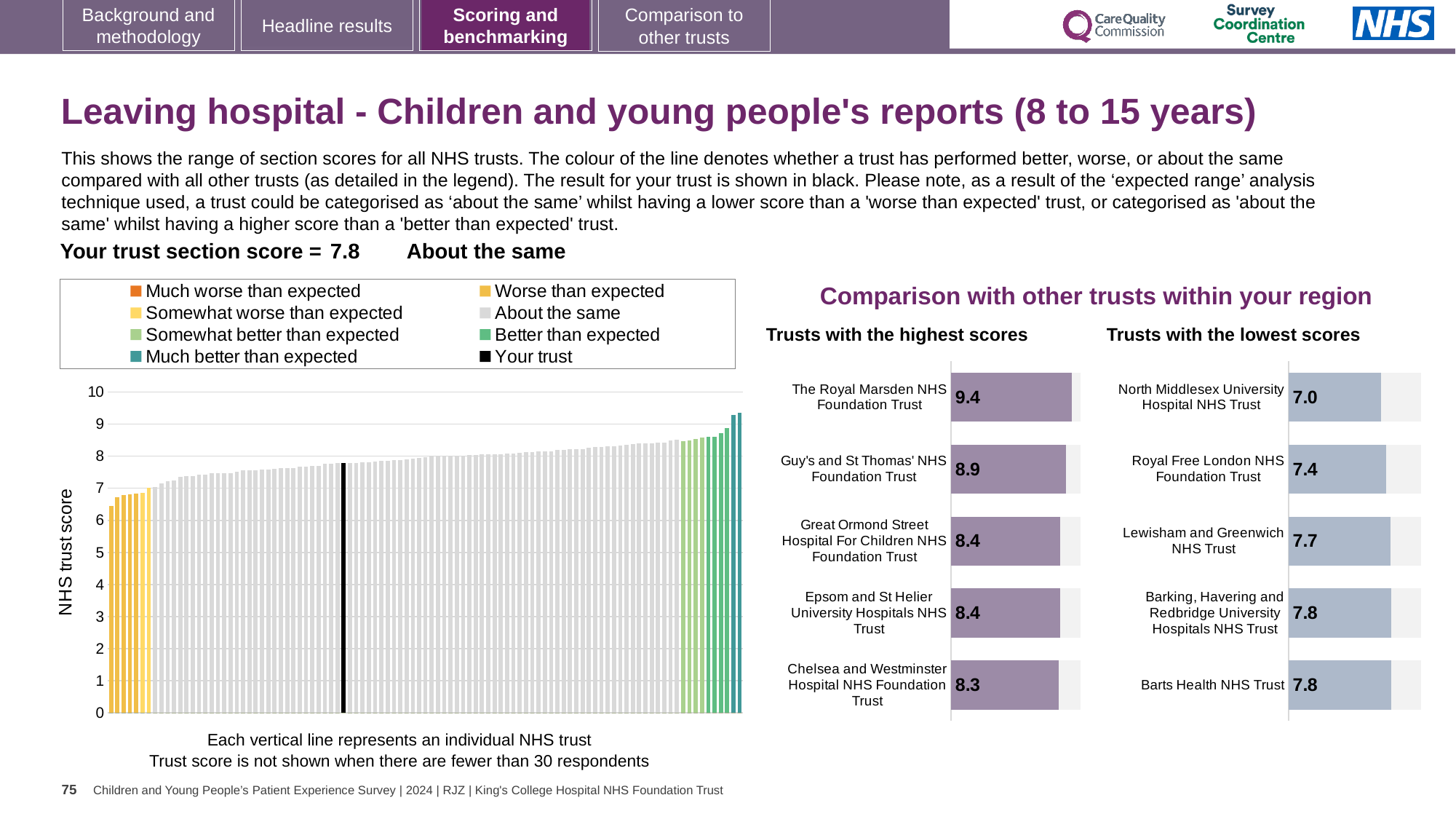
In the main 'NHS trust score' chart, what is the section score for your trust (the black bar)? 7.8 In the 'Trusts with the lowest scores' chart, how much higher is the score for Barts Health NHS Trust than for North Middlesex University Hospital NHS Trust? 0.8 What kind of chart is the main 'NHS trust score' chart on the left of the slide? Bar chart In the 'Trusts with the lowest scores' chart, what is the score for North Middlesex University Hospital NHS Trust? 7.0 In the 'Trusts with the lowest scores' chart, which trust has the lowest score? North Middlesex University Hospital NHS Trust In the 'Trusts with the highest scores' chart, what is the score for The Royal Marsden NHS Foundation Trust? 9.4 In the 'Trusts with the lowest scores' chart, which has the larger score: Royal Free London NHS Foundation Trust or Lewisham and Greenwich NHS Trust? Lewisham and Greenwich NHS Trust In the 'Trusts with the highest scores' chart, what is the difference between the scores of The Royal Marsden NHS Foundation Trust and Guy's and St Thomas' NHS Foundation Trust? 0.5 How many entries does the legend of the main 'NHS trust score' chart list? 8 In the 'Trusts with the highest scores' chart, which trust has the highest score? The Royal Marsden NHS Foundation Trust In the main 'NHS trust score' chart, do the values rise or fall from left to right? Rise How many trusts are shown in the 'Trusts with the highest scores' chart? 5